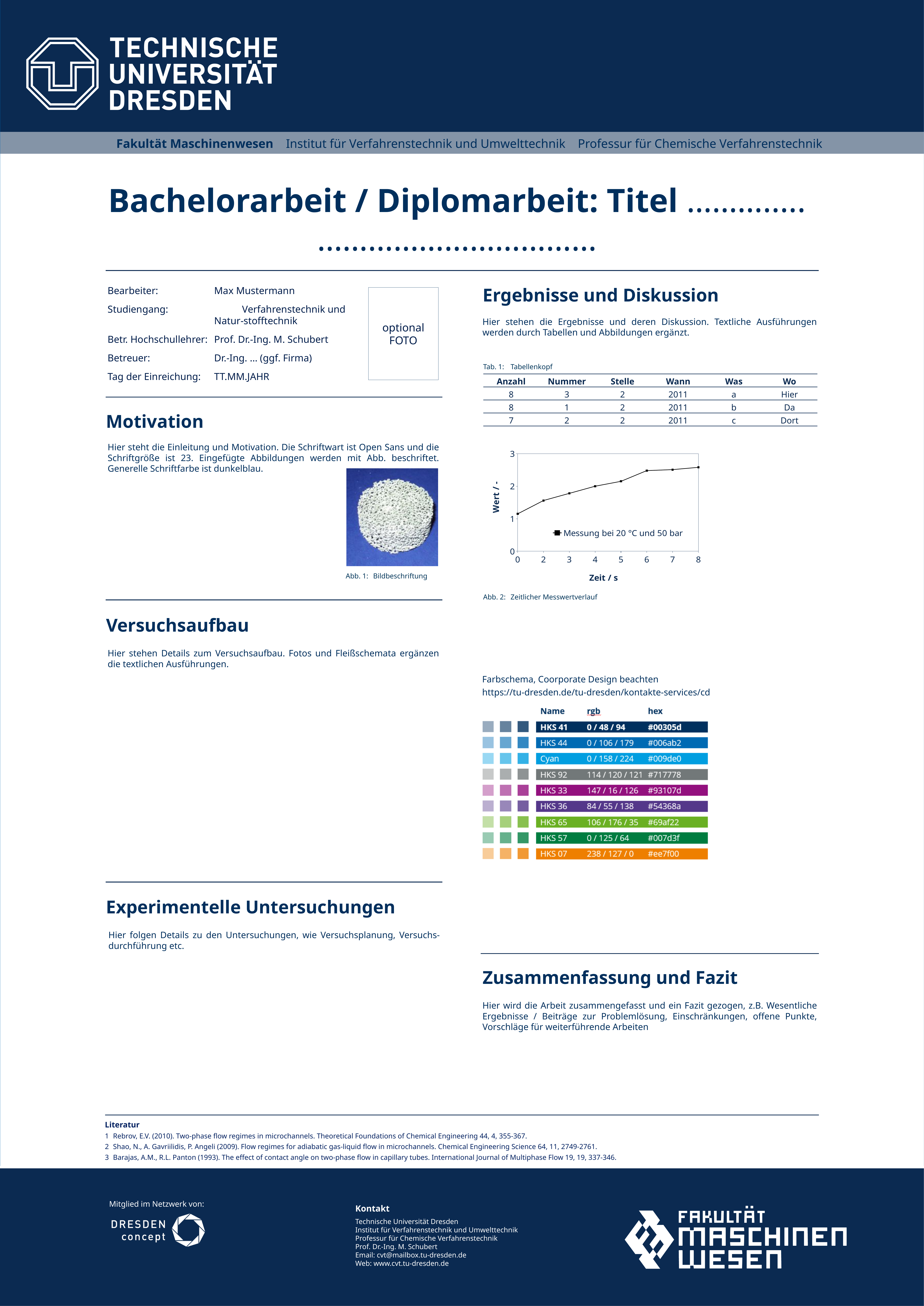
Do the values in the chart rise or fall as Zeit increases? rise What is the label of the x axis of the chart? Zeit / s Which is larger, the value at Zeit 0 s or at Zeit 8 s? Zeit 8 s What kind of chart is shown in Abb. 2? line chart At which Zeit is the plotted value highest? 8 What is the legend entry of the series in the chart? Messung bei 20 °C und 50 bar Is the value at Zeit 8 s greater or less than 3? less How many series does the legend of the chart list? 1 Is the value at Zeit 0 s greater or less than 2? less Is the value at Zeit 0 s greater or less than 1? greater At which Zeit is the plotted value lowest? 0